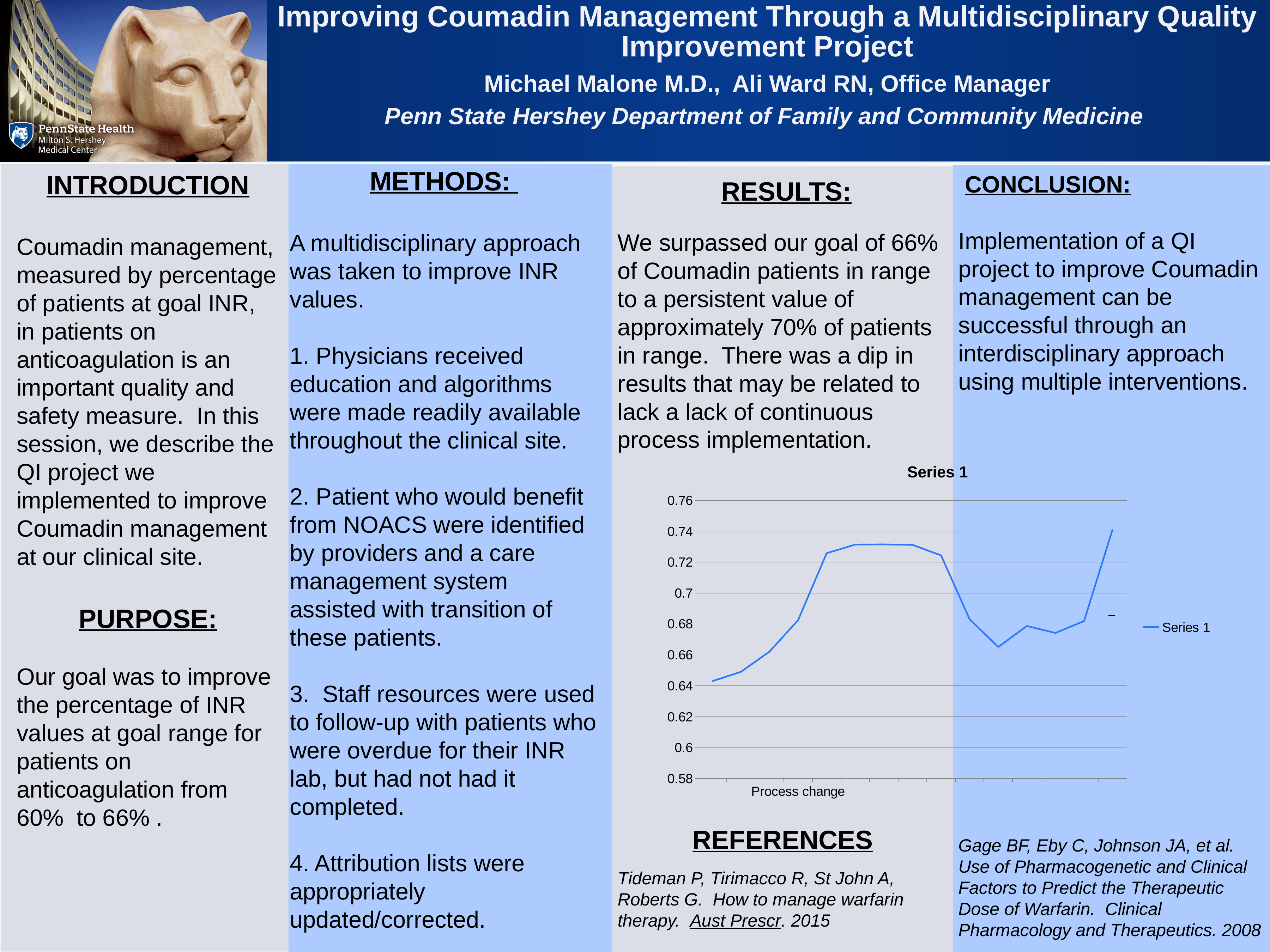
What kind of chart is shown on the slide? line chart What is the highest value shown on the y axis of the chart? 0.76 Overall, does the line rise or fall from the first point to the last point? rise Which is larger, the first plotted value or the last plotted value of Series 1? the last plotted value Is the lowest point of the dip in the middle-right of the line greater or less than 0.68? less What is the label shown on the x axis of the chart? Process change Where along the x axis does the line reach its lowest value? at the first point (far left) Is the first plotted value of Series 1 greater or less than 0.66? less Is the last plotted value of Series 1 greater or less than 0.72? greater What is the title of the chart? Series 1 Where along the x axis does the line reach its highest value? at the last point (far right) How many series does the chart legend list? 1